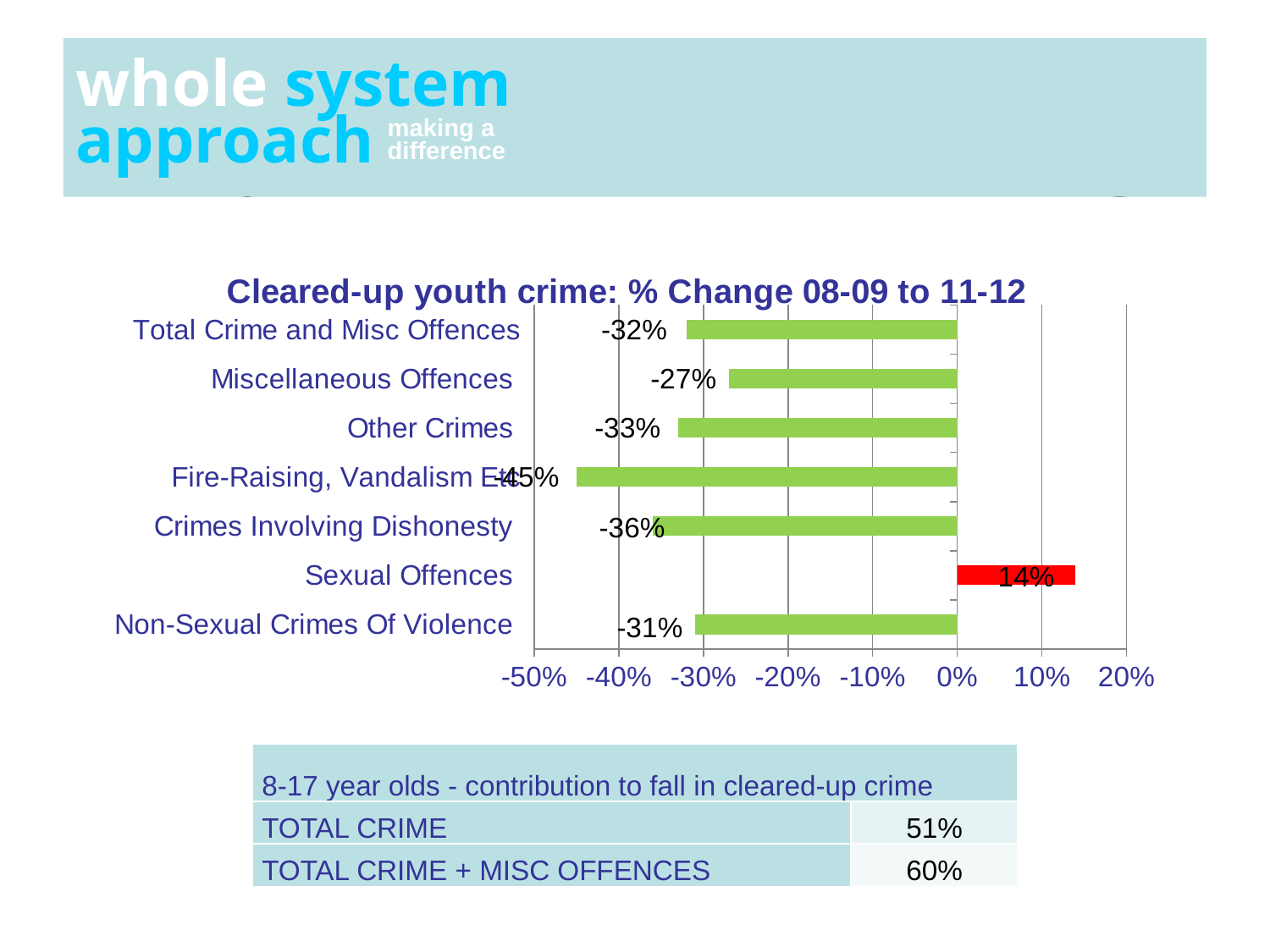
Which category has the highest value? Sexual Offences What is the value for Crimes Involving Dishonesty? -36% What is the value for Non-Sexual Crimes Of Violence? -31% What is the difference between the values for Other Crimes and Miscellaneous Offences? 6% Which category has the lowest value? Fire-Raising, Vandalism Etc What is the value for Miscellaneous Offences? -27% What is the title of the chart? Cleared-up youth crime: % Change 08-09 to 11-12 What kind of chart is shown on the slide? Bar chart What is the value for Sexual Offences? 14% Which is larger, the value for Crimes Involving Dishonesty or the value for Non-Sexual Crimes Of Violence? Non-Sexual Crimes Of Violence What is the value for Total Crime and Misc Offences? -32% How many categories are shown in the chart? 7